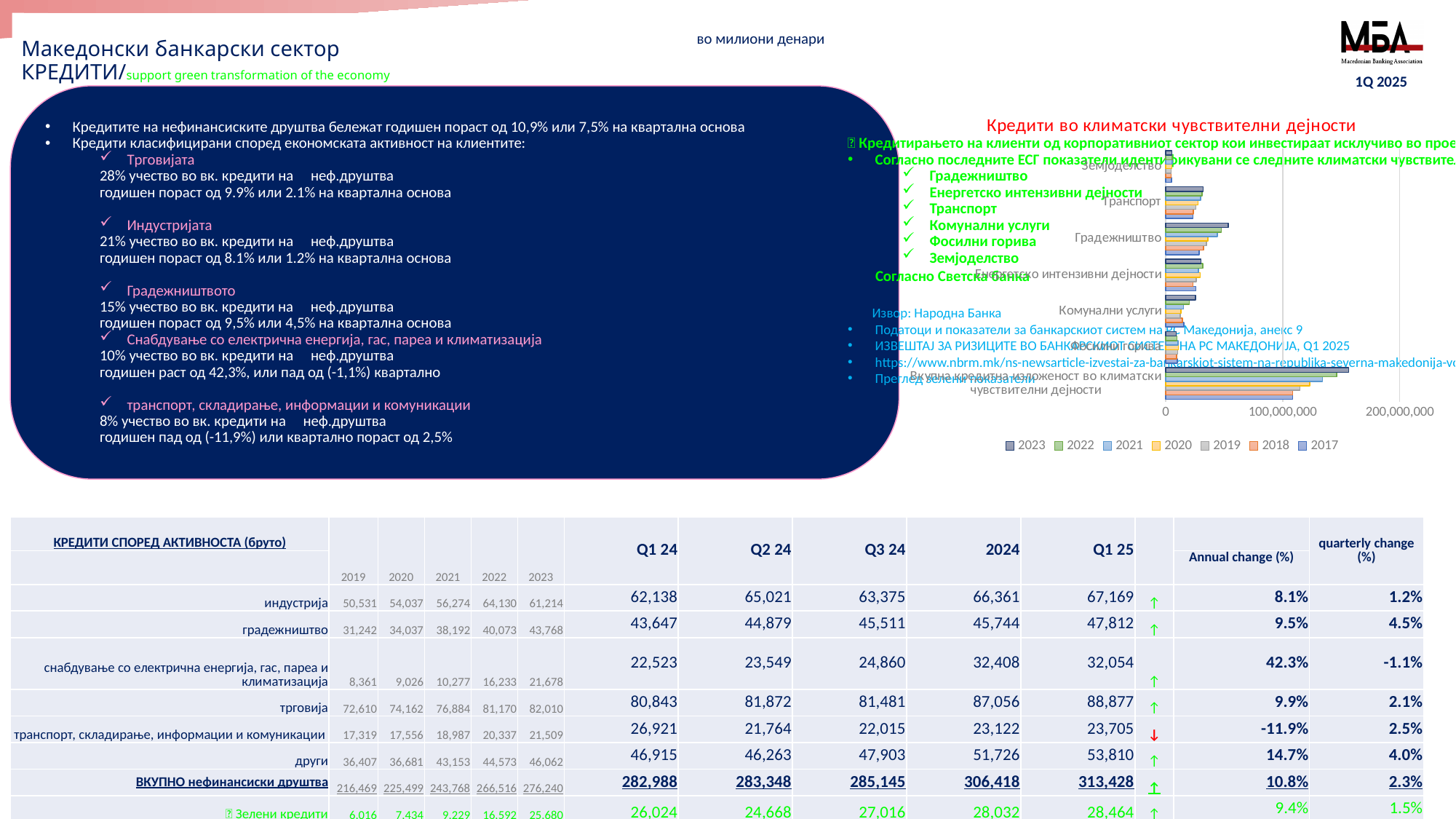
Which year is listed first in the legend of the "Кредити во климатски чувствителни дејности" chart? 2023 What is the highest tick label shown on the x axis of the "Кредити во климатски чувствителни дејности" chart? 200,000,000 How many categories are plotted on the y axis of the "Кредити во климатски чувствителни дејности" chart? 7 In the "Кредити во климатски чувствителни дејности" chart, is the 2023 value for Градежништво greater or less than 100,000,000? less In the "Кредити во климатски чувствителни дејности" chart, is the 2023 value for Вкупна кредитна изложеност во климатски чувствителни дејности greater or less than 100,000,000? greater In the "Кредити во климатски чувствителни дејности" chart, which has the larger 2023 value: Градежништво or Комунални услуги? Градежништво In the "Кредити во климатски чувствителни дејности" chart, is the value for Вкупна кредитна изложеност во климатски чувствителни дејности larger in 2023 or in 2017? 2023 How many series does the legend of the "Кредити во климатски чувствителни дејности" chart list? 7 What kind of chart is shown under the title "Кредити во климатски чувствителни дејности"? bar chart In the "Кредити во климатски чувствителни дејности" chart, is the 2023 value for Земјоделство greater or less than 100,000,000? less Which category has the longest bars in the "Кредити во климатски чувствителни дејности" chart? Вкупна кредитна изложеност во климатски чувствителни дејности